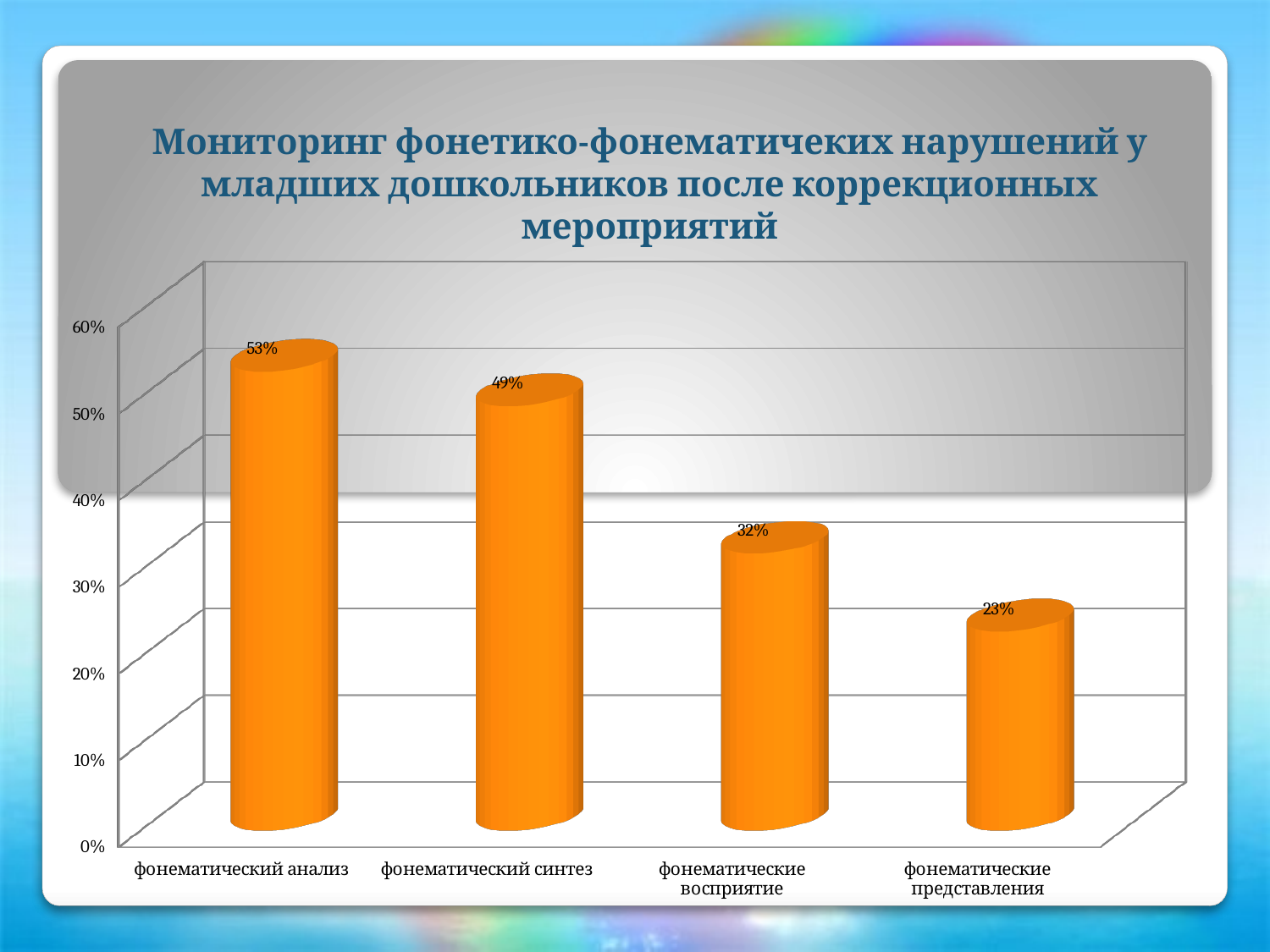
What kind of chart is shown on the slide? bar chart Which category has the lowest value? фонематические представления How many categories are shown on the chart? 4 What is the value for фонематические восприятие? 32% Which category has the highest value? фонематический анализ What is the difference between the values for фонематический анализ and фонематические представления? 30% What is the value for фонематический синтез? 49% What is the value for фонематические представления? 23% What is the value for фонематический анализ? 53% Do the values rise or fall from left to right along the x axis? fall What is the difference between the values for фонематический синтез and фонематические восприятие? 17% Which is larger, the value for фонематические восприятие or фонематические представления? фонематические восприятие